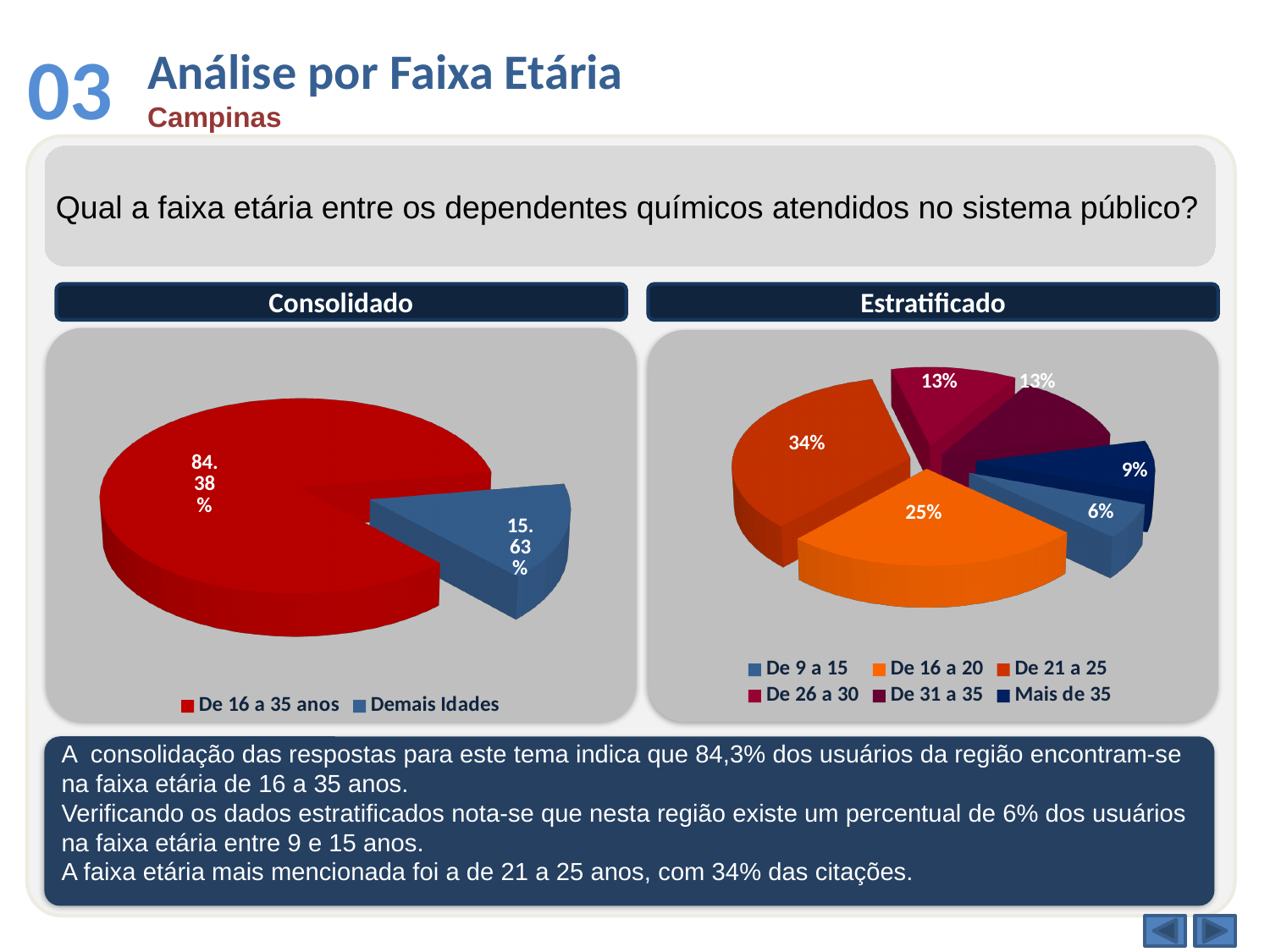
What kind of chart is the Consolidado chart? Pie chart In the Consolidado chart, what percentage is shown for De 16 a 35 anos? 84.38% In the Estratificado chart, what percentage is shown for De 21 a 25? 34% In the Estratificado chart, what percentage is shown for De 9 a 15? 6% In the Consolidado chart, what percentage is shown for Demais Idades? 15.63% In the Estratificado chart, what is the difference between the De 21 a 25 share and the De 16 a 20 share? 9% How many entries does the legend of the Estratificado chart list? 6 In the Consolidado chart, what colour is the De 16 a 35 anos slice? Red In the Estratificado chart, which age group has the smallest share? De 9 a 15 In the Estratificado chart, which is larger: De 16 a 20 or Mais de 35? De 16 a 20 In the Consolidado chart, what is the difference between the De 16 a 35 anos slice and the Demais Idades slice? 68.75% In the Estratificado chart, which age group has the largest share? De 21 a 25